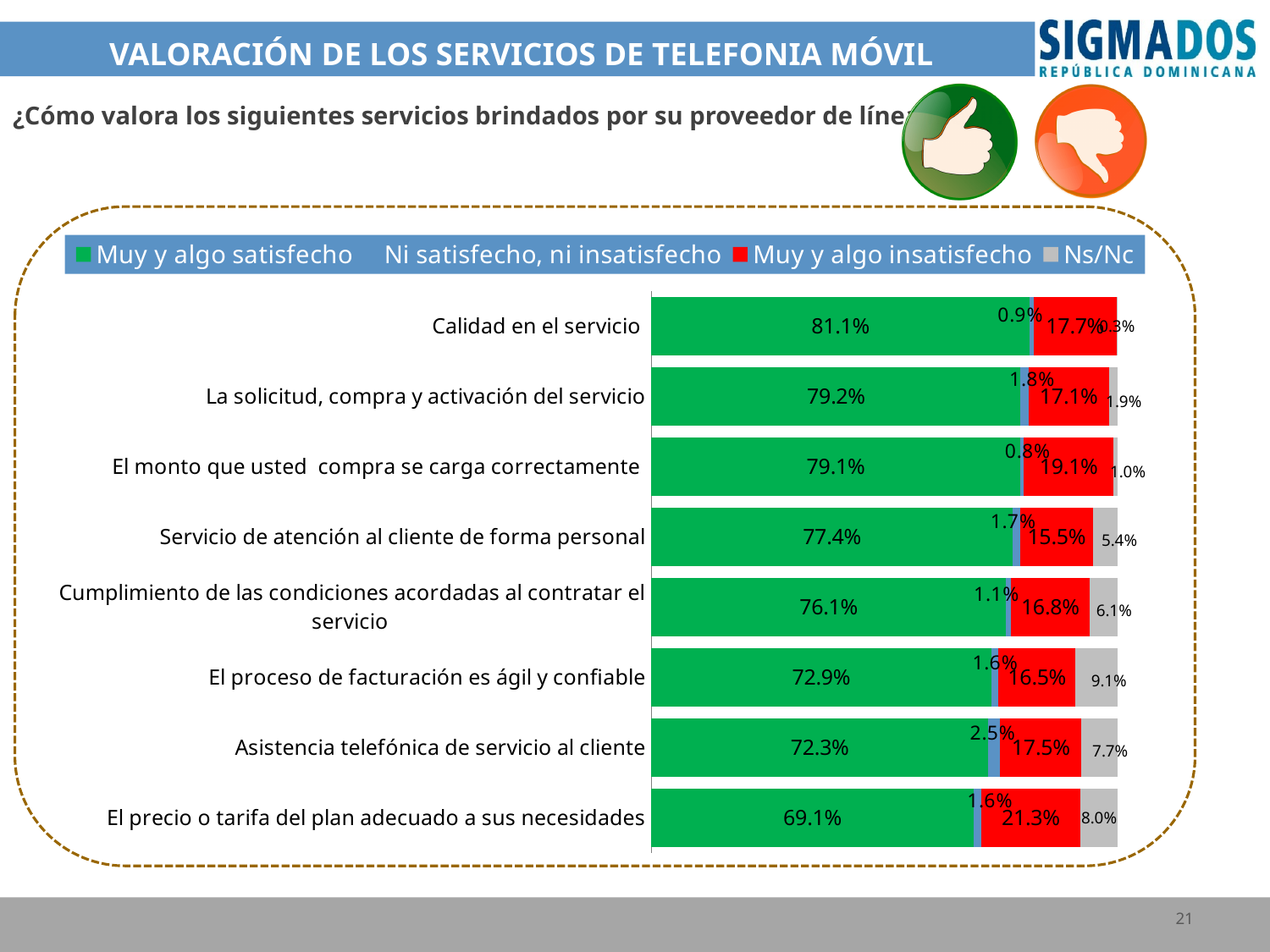
What is the difference between the 'Muy y algo satisfecho' values for 'Calidad en el servicio' and 'El precio o tarifa del plan adecuado a sus necesidades'? 12.0% What kind of chart is shown on the slide? Stacked bar chart How many series does the legend list? 4 Which has a larger 'Ns/Nc' value: 'Servicio de atención al cliente de forma personal' or 'Cumplimiento de las condiciones acordadas al contratar el servicio'? Cumplimiento de las condiciones acordadas al contratar el servicio What is the 'Muy y algo insatisfecho' value for 'El precio o tarifa del plan adecuado a sus necesidades'? 21.3% Which category has the highest 'Muy y algo insatisfecho' value? El precio o tarifa del plan adecuado a sus necesidades Which category has the highest 'Muy y algo satisfecho' value? Calidad en el servicio What is the 'Ns/Nc' value for 'El proceso de facturación es ágil y confiable'? 9.1% What is the 'Ni satisfecho, ni insatisfecho' value for 'Asistencia telefónica de servicio al cliente'? 2.5% How many categories (services) are shown in the chart? 8 Which category has the lowest 'Muy y algo satisfecho' value? El precio o tarifa del plan adecuado a sus necesidades What is the 'Muy y algo satisfecho' value for 'Calidad en el servicio'? 81.1%